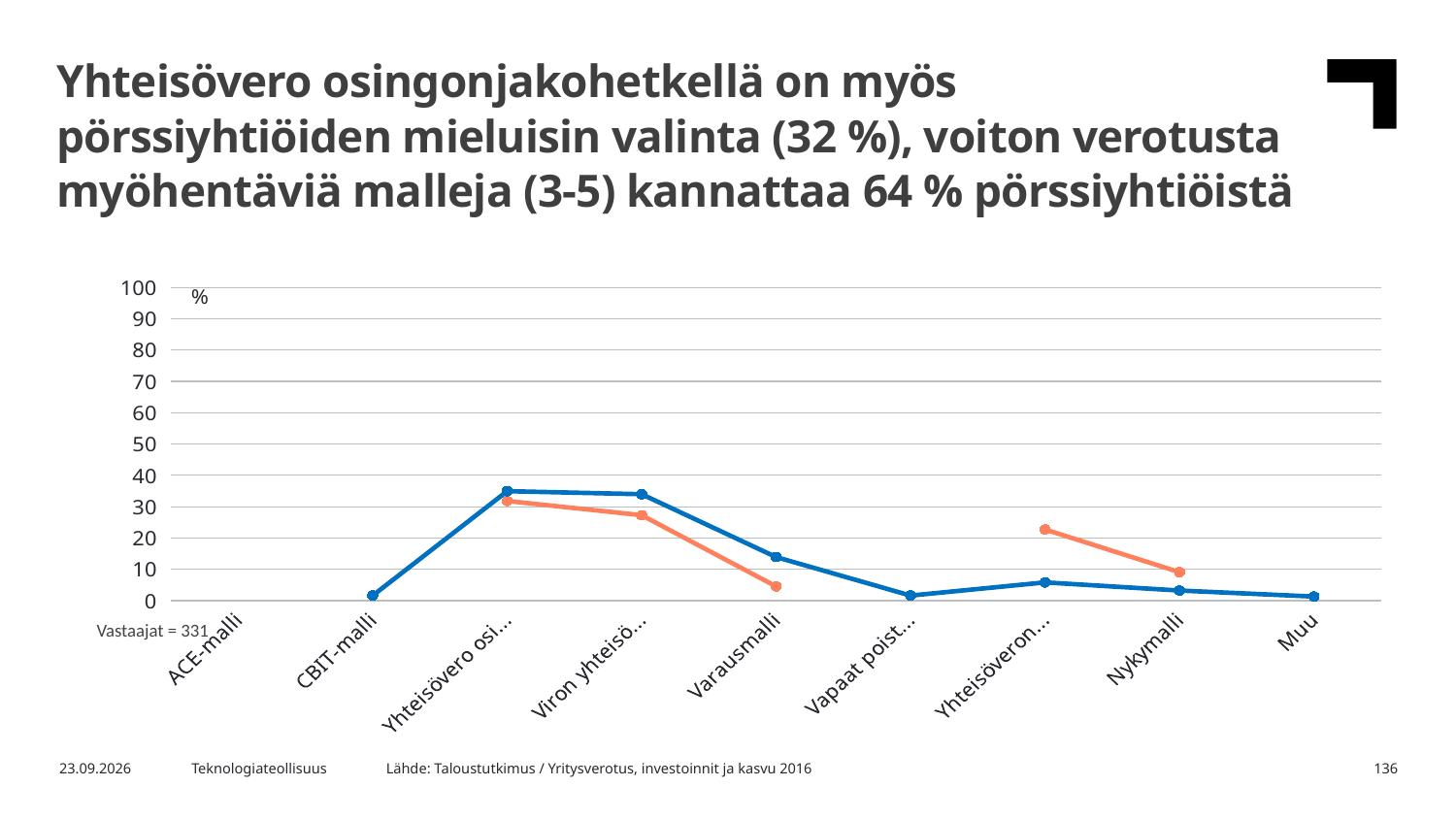
At Varausmalli, which line has the larger value, the blue line or the orange line? blue line What kind of chart is shown on the slide? line chart Is the value of the orange line for Yhteisöveron... greater or less than 20? greater How many categories are shown on the x axis of the chart? 9 What is the number of respondents (Vastaajat) noted below the chart? 331 At Nykymalli, which line has the larger value, the blue line or the orange line? orange line Is the value of the blue line for Nykymalli greater or less than 10? less Does the blue line rise or fall from Viron yhteisö... to Vapaat poist...? fall Is the value of the blue line for Muu greater or less than 10? less Which category has the highest value on the orange line? Yhteisövero osi...